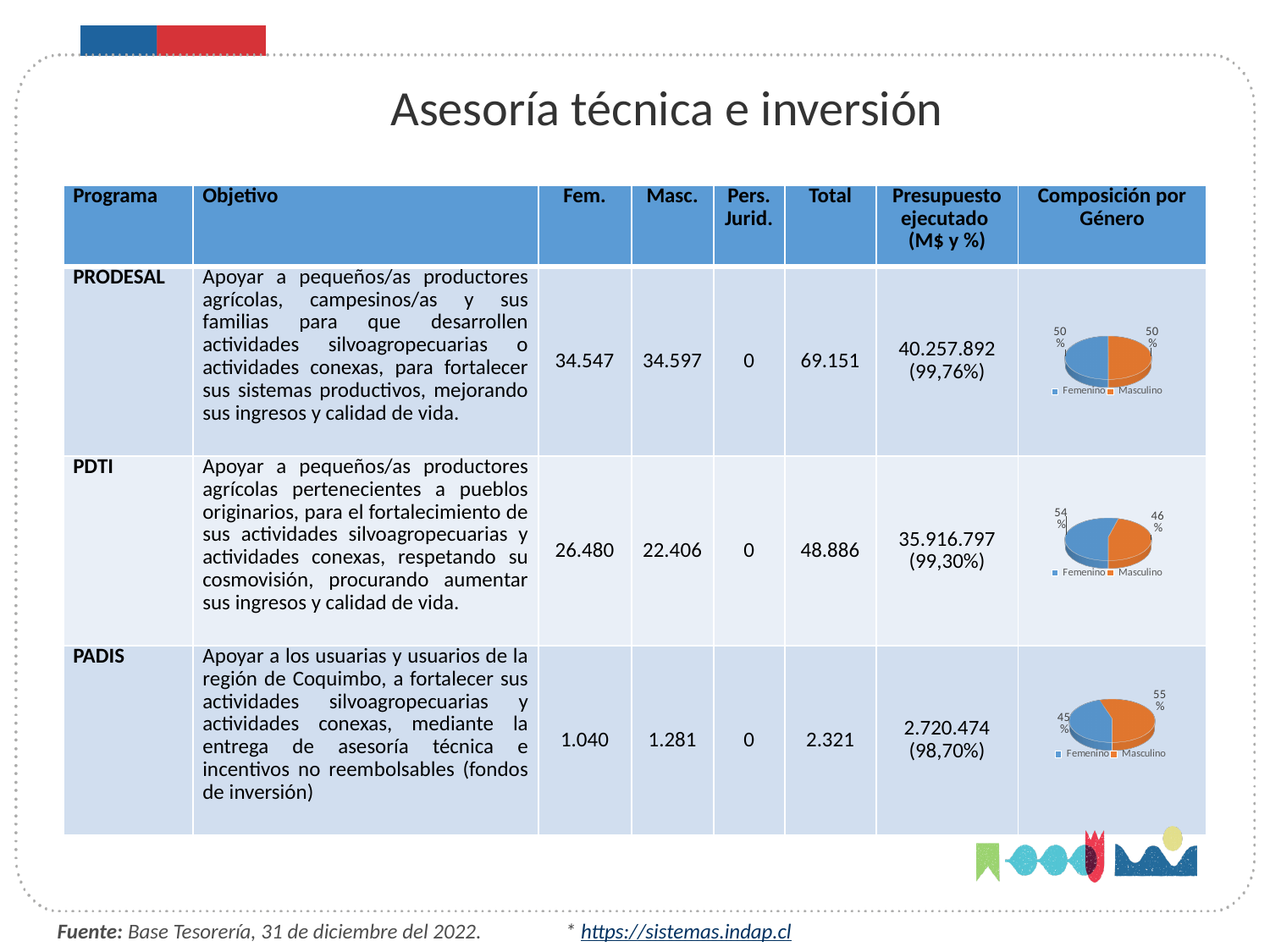
In the pie charts in the Composición por Género column, which colour represents Femenino? Blue In the PADIS row's pie chart, what share is labelled for Masculino? 55% In the PRODESAL row's pie chart, what share is labelled for Femenino? 50% In the PADIS row's pie chart, what share is labelled for Femenino? 45% In the PDTI row's pie chart, what is the difference between the Femenino and Masculino shares? 8% What kind of chart is shown in the Composición por Género column for each program? Pie chart In the PDTI row's pie chart, what share is labelled for Femenino? 54% How many entries does the legend of the PRODESAL row's pie chart list? 2 In the PADIS row's pie chart, which slice is the largest? Masculino In the PADIS row's pie chart, what is the difference between the Masculino and Femenino shares? 10% In the PDTI row's pie chart, what share is labelled for Masculino? 46% In the PDTI row's pie chart, which slice is larger, Femenino or Masculino? Femenino